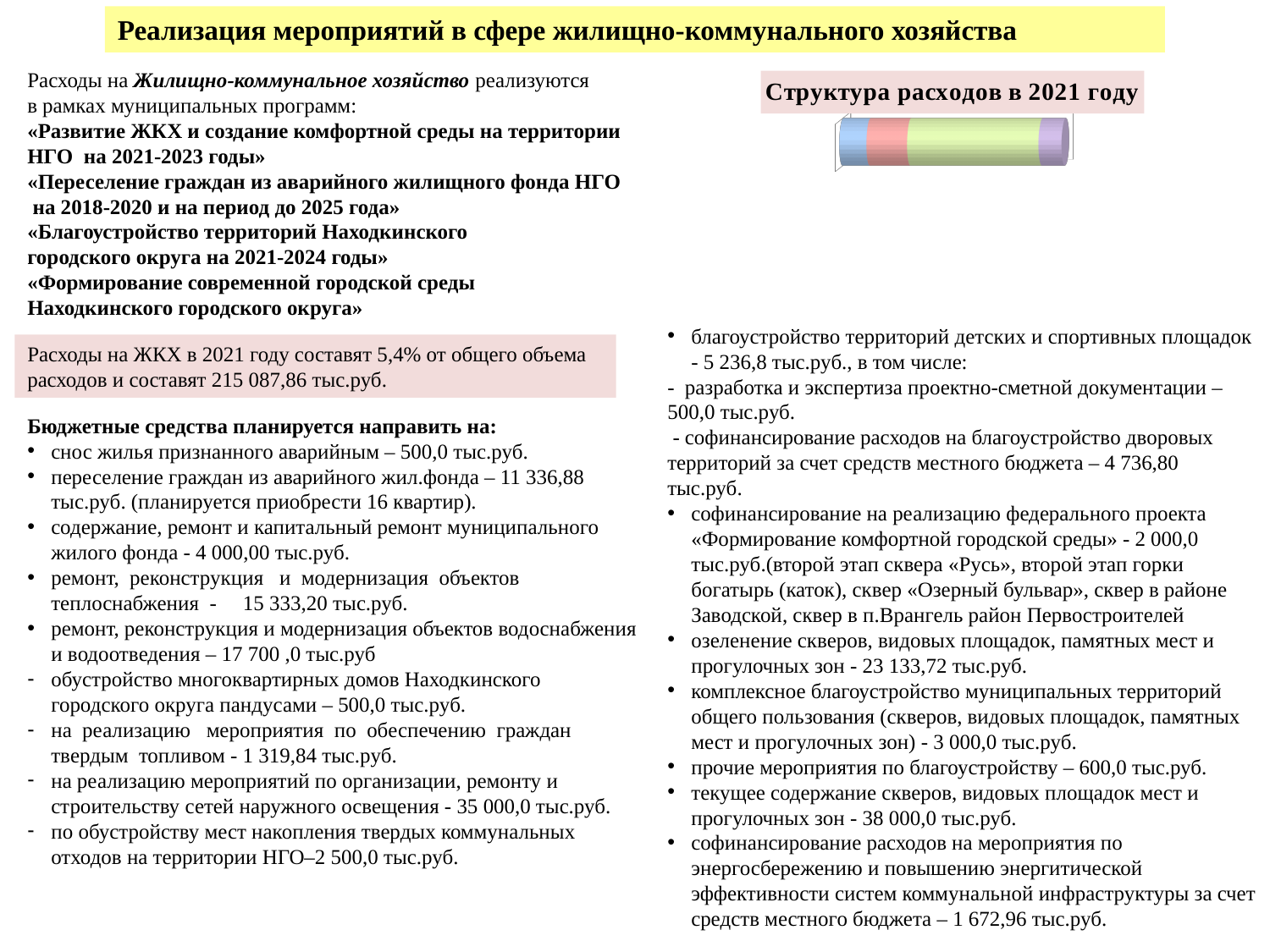
What is the title of the chart on the slide? Структура расходов в 2021 году Does the chart «Структура расходов в 2021 году» display a legend? No Is the bar in the chart «Структура расходов в 2021 году» horizontal or vertical? horizontal In the chart «Структура расходов в 2021 году», which colour segment is the largest? green How many coloured segments make up the stacked bar in the chart «Структура расходов в 2021 году»? 4 What kind of chart is shown under the heading «Структура расходов в 2021 году»? bar chart